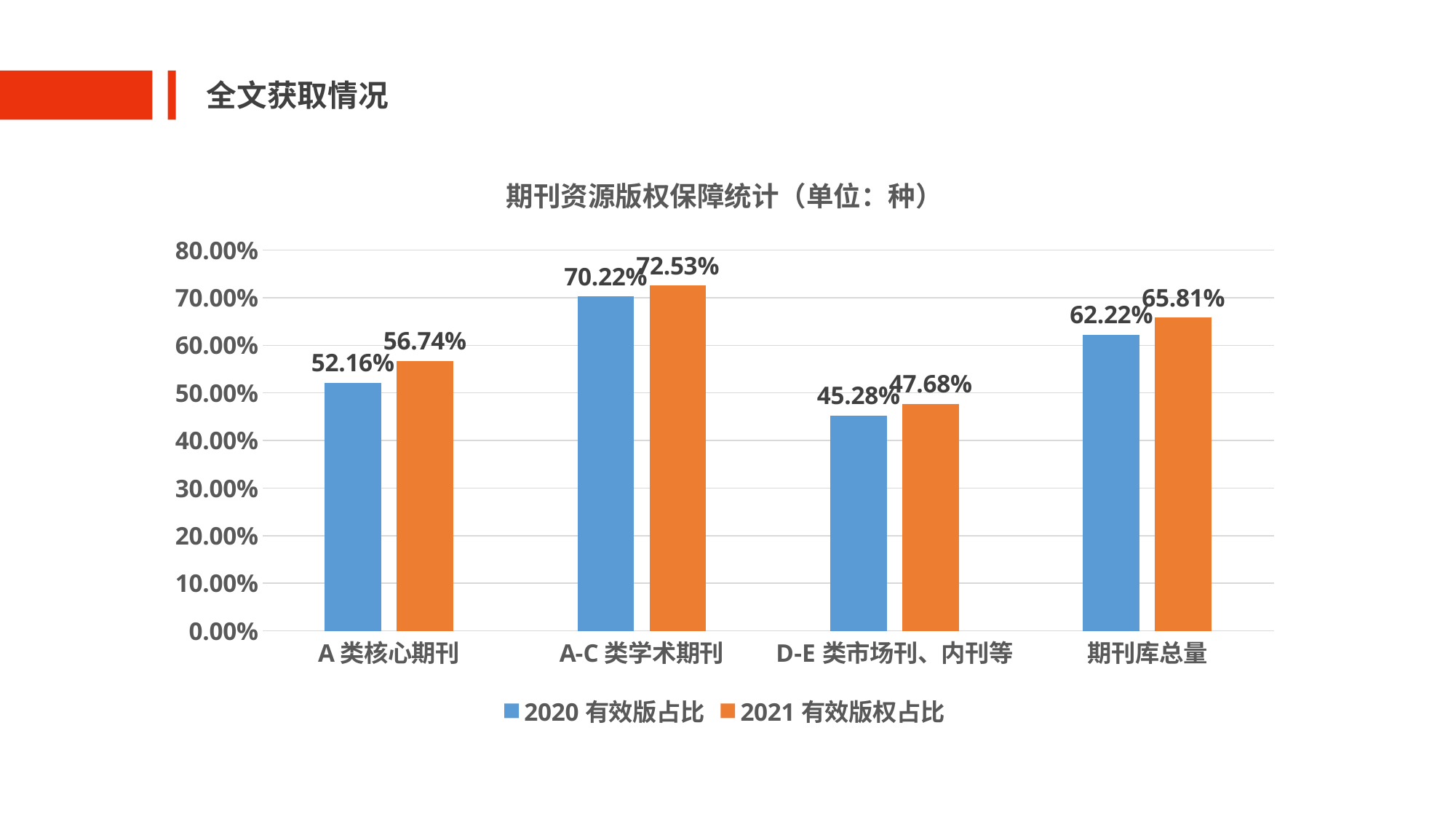
What is the 2020 有效版占比 value for 期刊库总量? 62.22% What is the 2021 有效版权占比 value for A-C 类学术期刊? 72.53% Which is larger for 期刊库总量: the 2020 有效版占比 value or the 2021 有效版权占比 value? 2021 有效版权占比 Which category has the highest 2021 有效版权占比 value? A-C 类学术期刊 How many categories are shown on the x axis? 4 Which category has the lowest 2020 有效版占比 value? D-E 类市场刊、内刊等 What is the difference between the 2021 and 2020 values for A 类核心期刊? 4.58% How many series does the legend list? 2 What is the 2020 有效版占比 value for A 类核心期刊? 52.16% What kind of chart is shown on the slide? Bar chart What is the title of the chart? 期刊资源版权保障统计（单位：种） What is the 2021 有效版权占比 value for D-E 类市场刊、内刊等? 47.68%